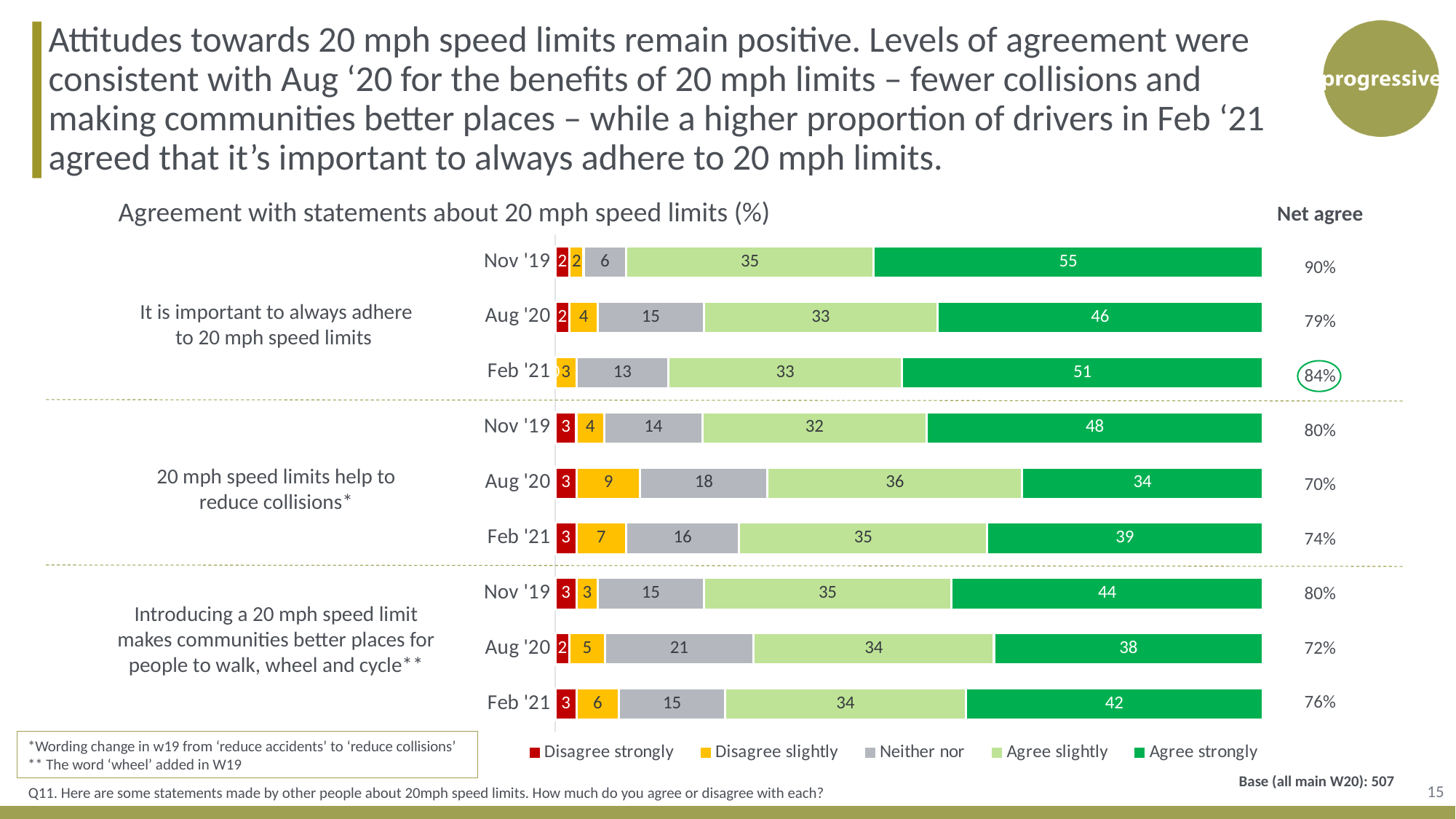
Which statement and wave has the lowest Net agree figure on the chart? 20 mph speed limits help to reduce collisions, Aug '20 (70%) For 'It is important to always adhere to 20 mph speed limits', how much higher is the 'Agree strongly' value in Feb '21 than in Aug '20? 5 For 'It is important to always adhere to 20 mph speed limits', did the Net agree figure rise or fall from Nov '19 to Aug '20? Fall What percentage of drivers agreed strongly in Nov '19 that it is important to always adhere to 20 mph speed limits? 55 What kind of chart is shown on the slide? Stacked bar chart How many bars are plotted on the chart in total? 9 Which is larger: the 'Agree slightly' value for reducing collisions in Aug '20, or the 'Agree slightly' value for making communities better places in Feb '21? Reducing collisions in Aug '20 (36) For the statement about making communities better places, what is the combined 'Agree slightly' and 'Agree strongly' value in Aug '20? 72 For the statement '20 mph speed limits help to reduce collisions', what is the 'Neither nor' value in Aug '20? 18 What is the Net agree figure for Feb '21 for the statement that introducing a 20 mph speed limit makes communities better places? 76% How many series does the legend list? 5 For the statement '20 mph speed limits help to reduce collisions', which wave has the highest 'Agree strongly' value? Nov '19